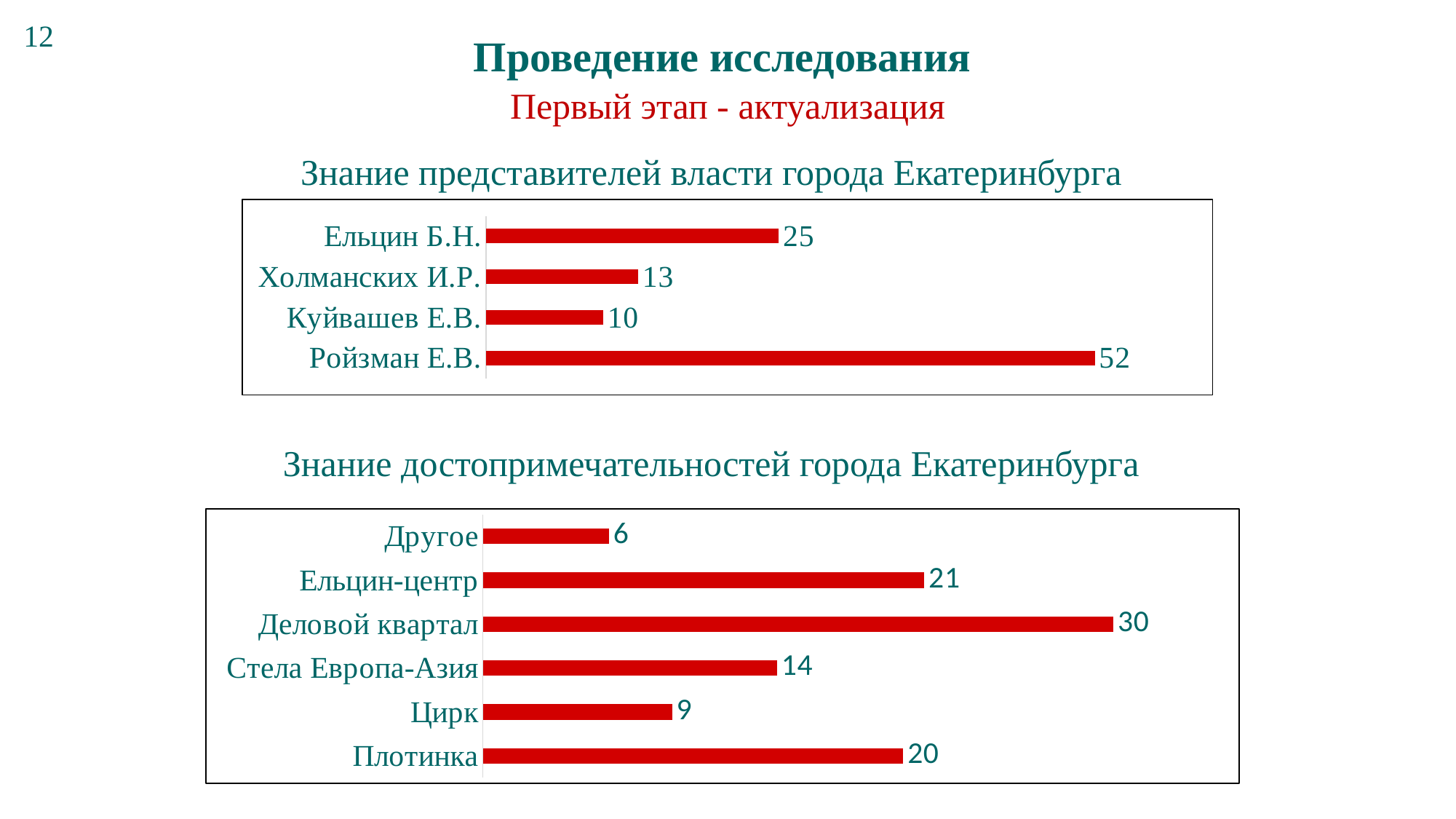
What type of chart is the top chart (Знание представителей власти города Екатеринбурга)? Bar chart In the bottom chart (Знание достопримечательностей города Екатеринбурга), what is the difference between the values for Деловой квартал and Цирк? 21 In the bottom chart (Знание достопримечательностей города Екатеринбурга), how many categories are shown? 6 In the top chart (Знание представителей власти города Екатеринбурга), how many categories are shown? 4 In the bottom chart (Знание достопримечательностей города Екатеринбурга), which is larger: the value for Ельцин-центр or the value for Плотинка? Ельцин-центр In the top chart (Знание представителей власти города Екатеринбурга), what is the value for Ройзман Е.В.? 52 In the bottom chart (Знание достопримечательностей города Екатеринбурга), which category has the lowest value? Другое In the top chart (Знание представителей власти города Екатеринбурга), which category has the lowest value? Куйвашев Е.В. In the bottom chart (Знание достопримечательностей города Екатеринбурга), what is the value for Стела Европа-Азия? 14 In the bottom chart (Знание достопримечательностей города Екатеринбурга), which category has the highest value? Деловой квартал In the top chart (Знание представителей власти города Екатеринбурга), what is the difference between the values for Ройзман Е.В. and Ельцин Б.Н.? 27 In the top chart (Знание представителей власти города Екатеринбурга), which category has the highest value? Ройзман Е.В.